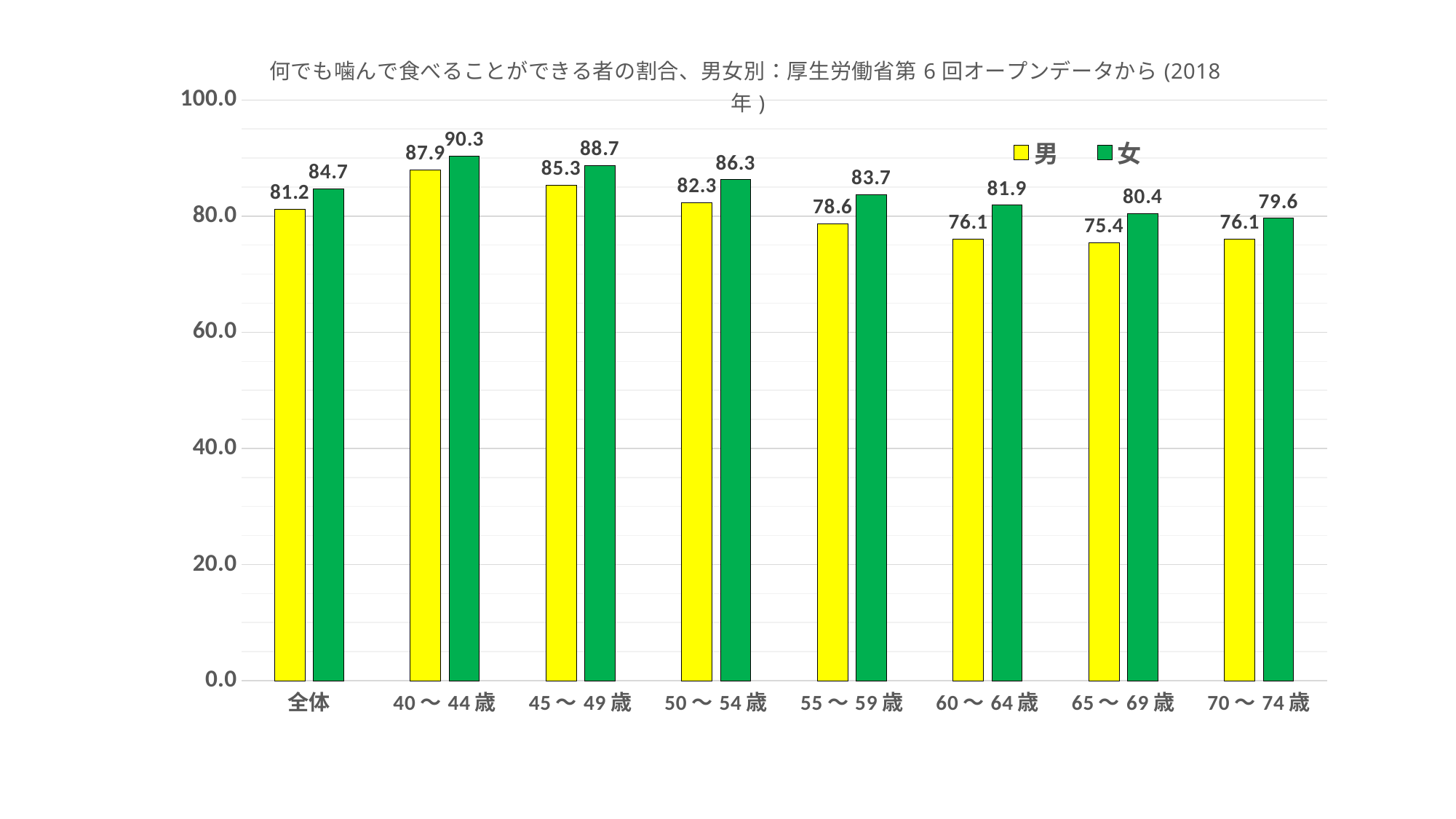
How many series does the legend list? 2 From 40～44歳 to 70～74歳, do the 女 (female) values rise or fall? Fall Which category has the lowest value for 男 (male)? 65～69歳 Which is larger in the 50～54歳 category, the 男 (male) value or the 女 (female) value? 女 (female) What kind of chart is shown on the slide? Bar chart How many categories are shown on the x axis? 8 What is the value for 女 (female) in the 40～44歳 category? 90.3 What is the value for 男 (male) in the 全体 category? 81.2 Which age category has the highest value for 女 (female)? 40～44歳 What colour are the bars for the 男 (male) series? Yellow What is the value for 男 (male) in the 65～69歳 category? 75.4 What is the difference between the 女 (female) and 男 (male) values in the 55～59歳 category? 5.1